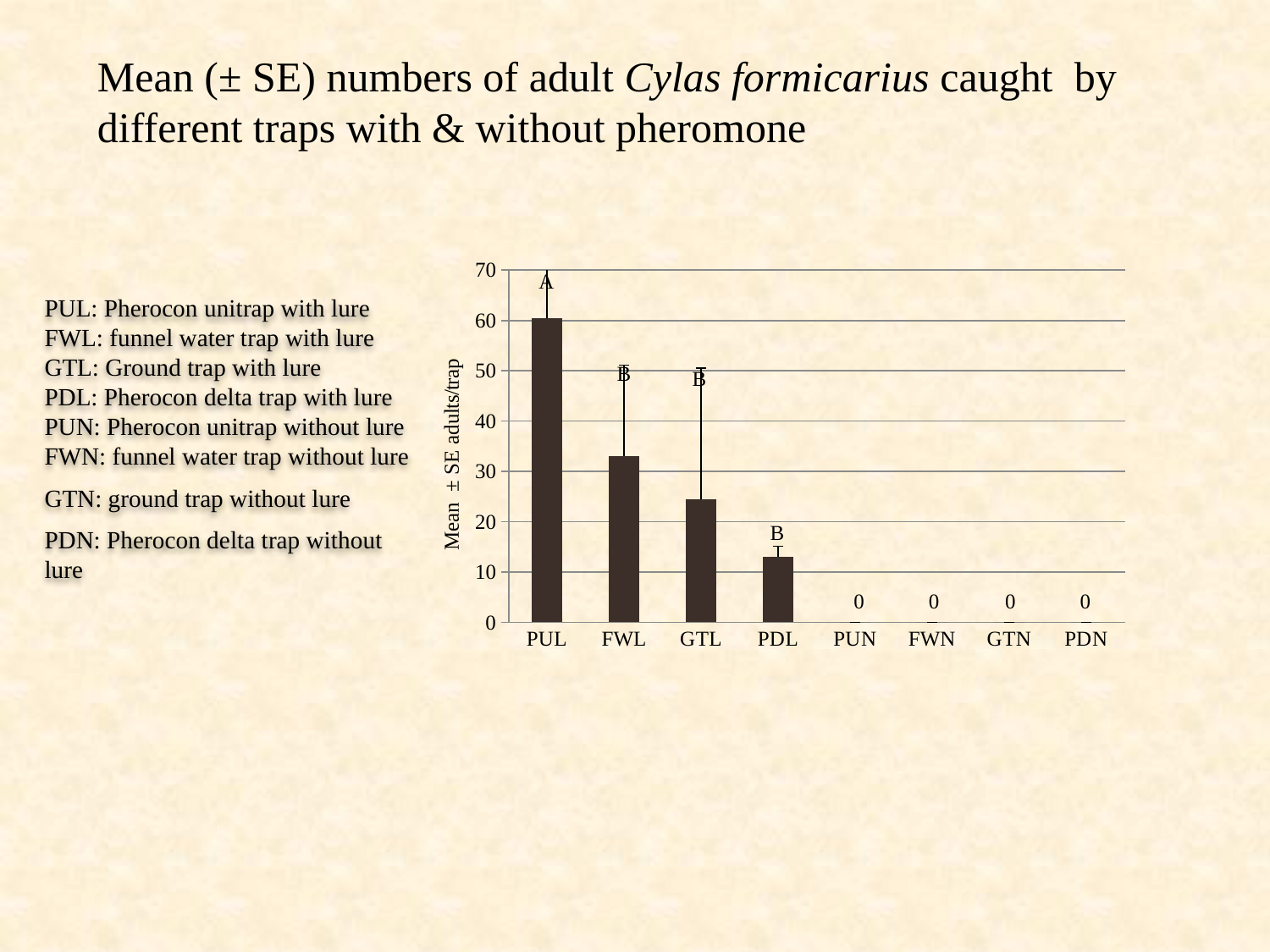
Is the value for GTL greater or less than 30? less What is the label on the y axis of the chart? Mean ± SE adults/trap What value is shown for PUN in the chart? 0 Is the value for PUL greater or less than 50? greater Is the value for PDL greater or less than 10? greater What value is shown for PDN in the chart? 0 Do the bar values rise or fall moving from PUL to PDN along the x axis? fall What kind of chart is shown on the slide? bar chart How many trap categories are shown on the x axis of the chart? 8 Which has a larger value, FWL or GTL? FWL Which trap category has the highest mean number of adults caught? PUL